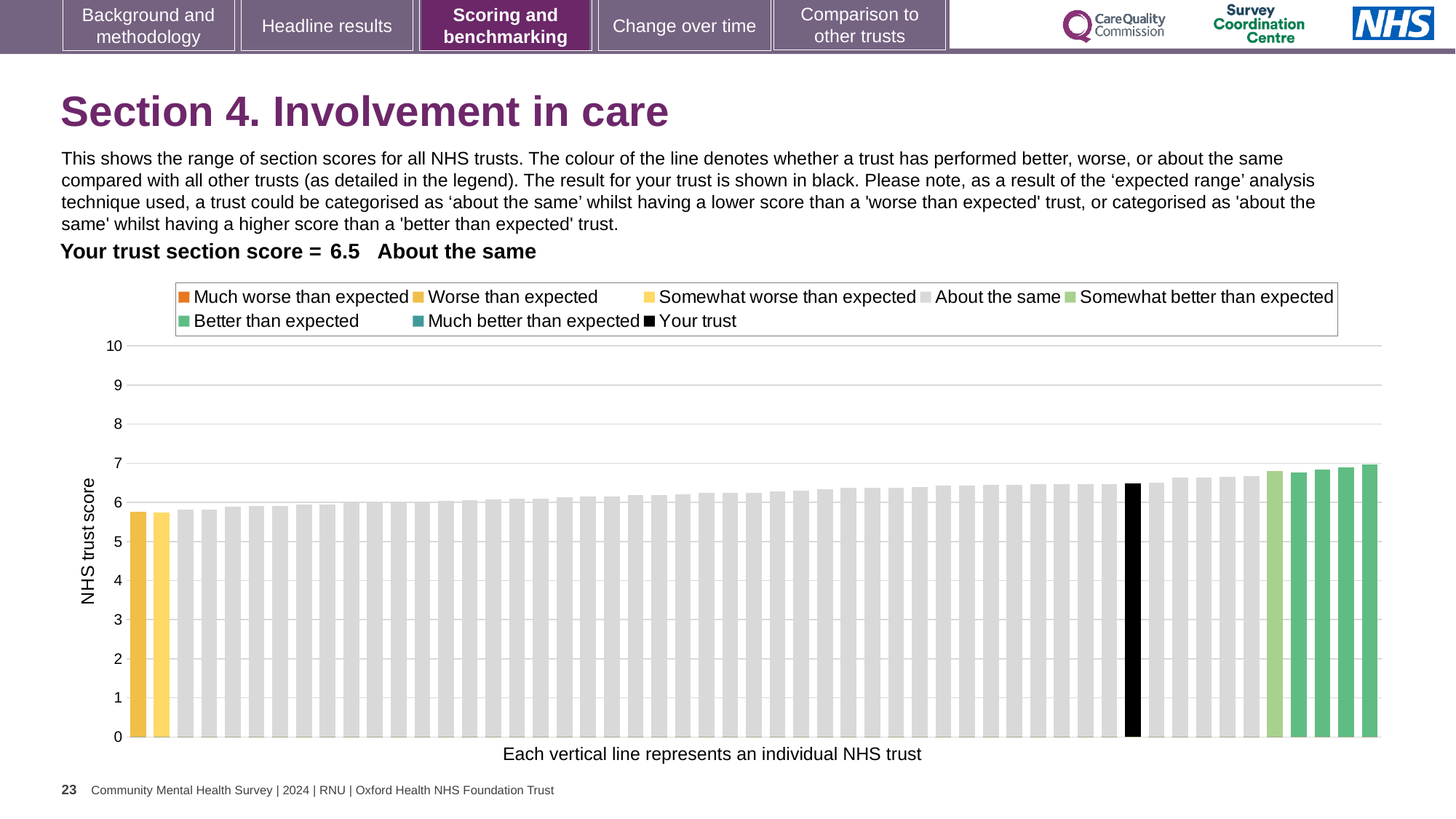
What is the label on the vertical axis of the chart? NHS trust score Is the value of the rightmost bar greater or less than 8? less Which performance category is the trust's section score assigned to? About the same How many entries does the chart legend list? 8 Is the value of the leftmost bar greater or less than 6? less Is the value of the tallest bar greater or less than 6? greater What is the trust's section score shown on the slide? 6.5 Is the highest bar at the left end or the right end of the chart? Right end What kind of chart is shown on the slide? Bar chart Do the bar values rise or fall from left to right along the x axis? Rise Which is taller, the black 'Your trust' bar or the leftmost bar? The black 'Your trust' bar